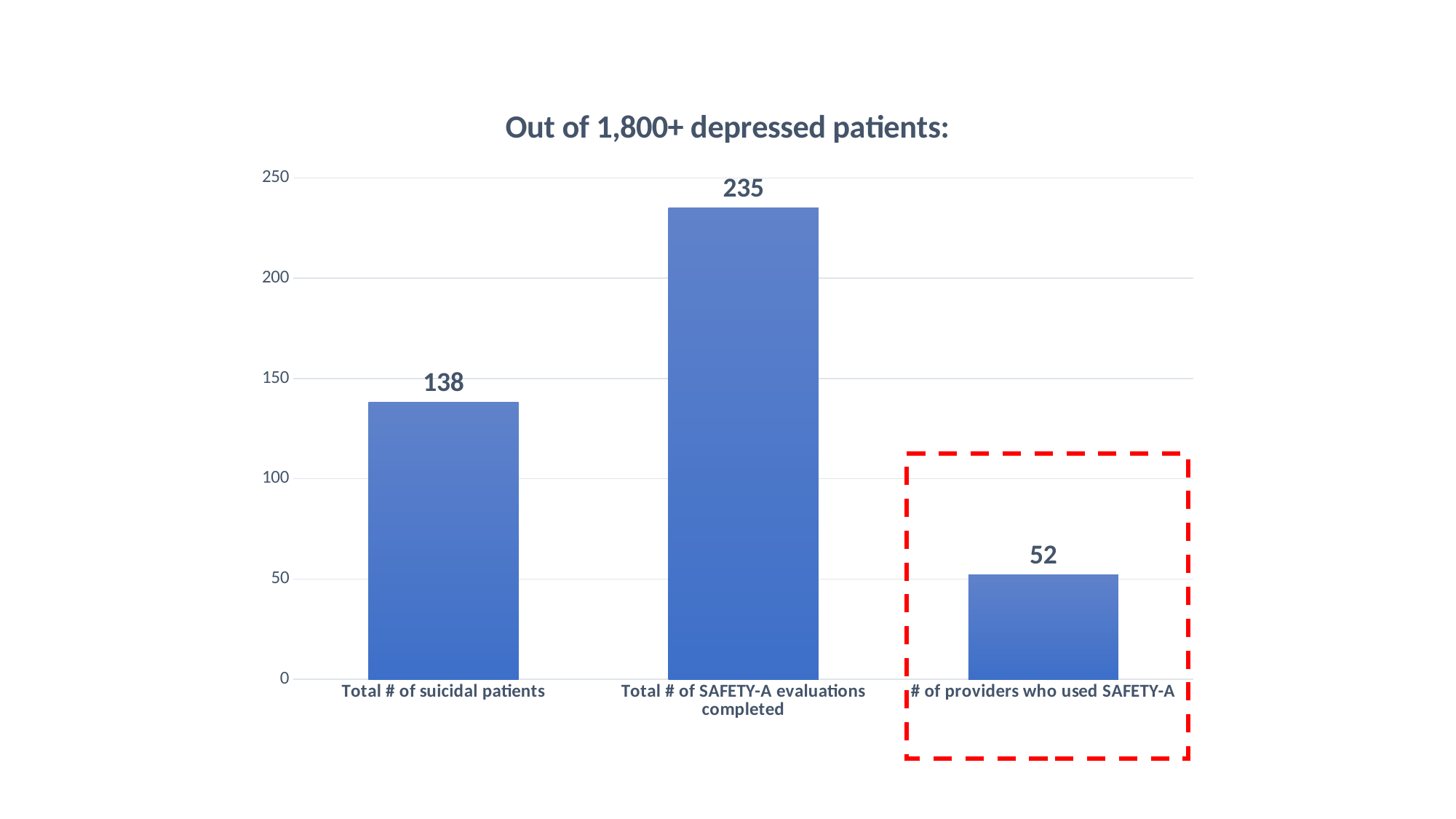
What is the difference between Total # of SAFETY-A evaluations completed and Total # of suicidal patients? 97 What is the title of the chart? Out of 1,800+ depressed patients: Is the value for Total # of SAFETY-A evaluations completed greater or less than 200? greater Which is larger: Total # of suicidal patients or # of providers who used SAFETY-A? Total # of suicidal patients Which category has the lowest value? # of providers who used SAFETY-A What is the value for # of providers who used SAFETY-A? 52 What is the value for Total # of suicidal patients? 138 What is the difference between Total # of suicidal patients and # of providers who used SAFETY-A? 86 How many categories are shown in the chart? 3 What is the value for Total # of SAFETY-A evaluations completed? 235 Which category has the highest value? Total # of SAFETY-A evaluations completed What kind of chart is shown on the slide? bar chart